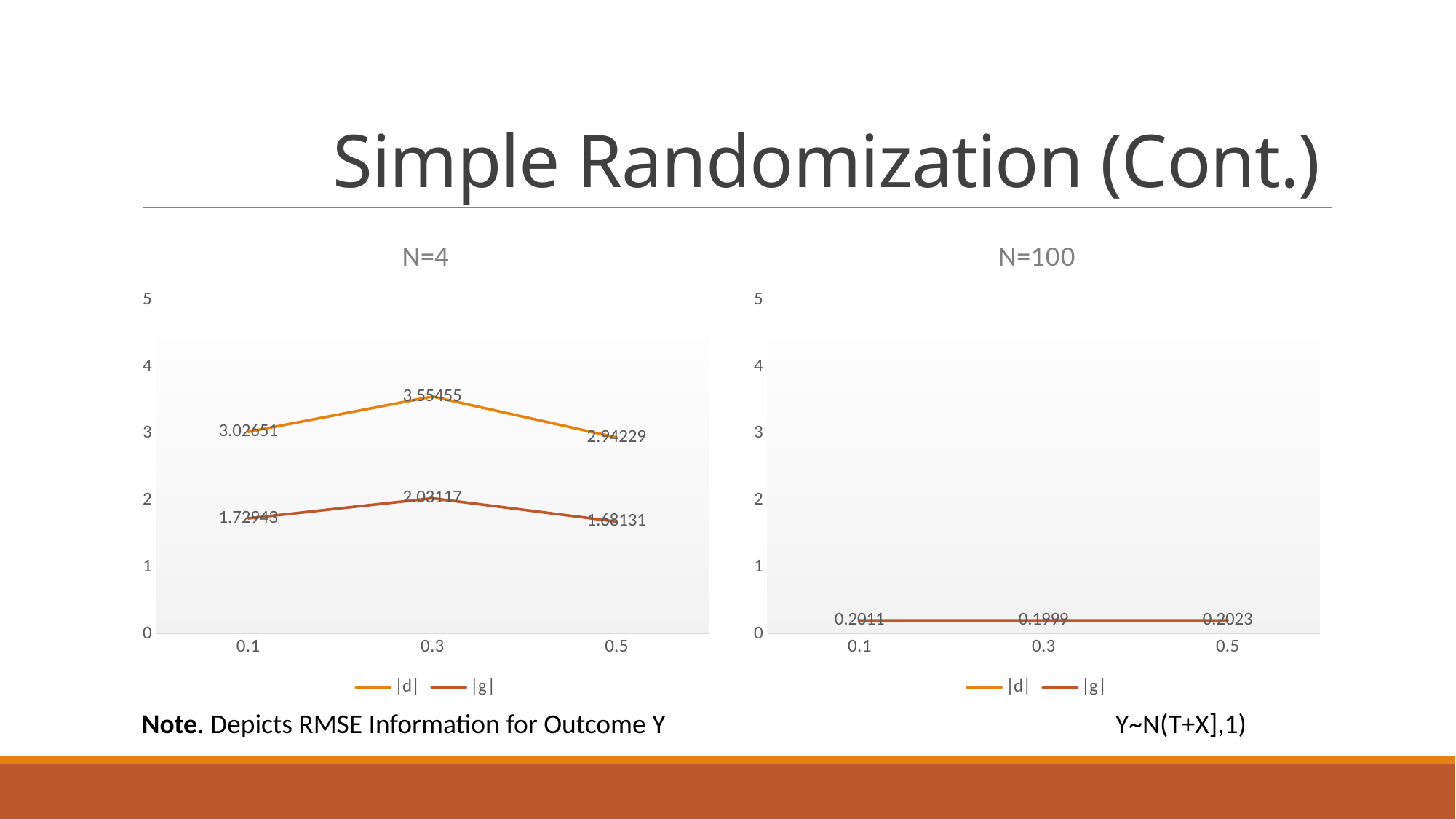
How many x-axis points are plotted in the N=100 chart? 3 In the N=100 chart, is the value for |d| at 0.1 greater or less than 1? less In the N=4 chart, at which x value is |g| lowest? 0.5 In the N=4 chart, at which x value does |d| reach its highest value? 0.3 How many series does the legend of the N=4 chart list? 2 What are the titles of the two charts on the slide? N=4 and N=100 In the N=4 chart, which is larger at 0.1: |d| or |g|? |d| In the N=4 chart, what is the difference between |d| and |g| at 0.3? 1.52338 What type of chart is the N=100 chart? Line chart In the N=4 chart, what is the value of |g| at 0.5? 1.68131 In the N=4 chart, what is the value of |d| at 0.3? 3.55455 In the N=4 chart, what is the value of |g| at 0.1? 1.72943